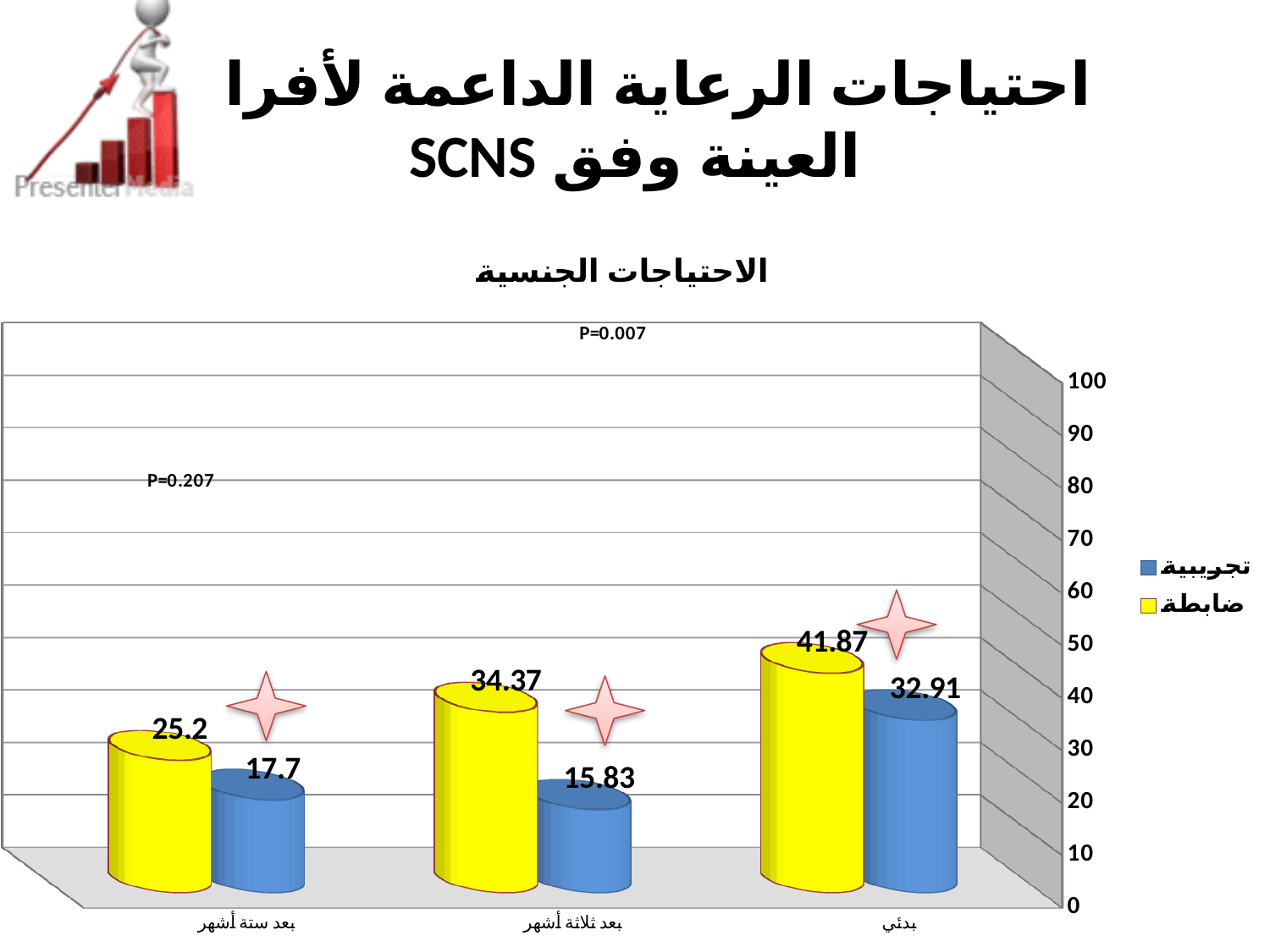
At بعد ستة أشهر, which series has the larger value, ضابطة or تجريبية? ضابطة What is the value for the تجريبية series at بعد ثلاثة أشهر? 15.83 What is the value for the ضابطة series at بعد ستة أشهر? 25.2 What is the value for the تجريبية series at بدئي? 32.91 What kind of chart is shown on the slide? bar chart Which category has the highest value for the تجريبية series? بدئي What is the difference between the ضابطة and تجريبية values at بعد ثلاثة أشهر? 18.54 What is the value for the ضابطة series at بدئي? 41.87 How many categories are shown on the x axis? 3 What is the title of the chart? الاحتياجات الجنسية Which category has the lowest value for the ضابطة series? بعد ستة أشهر How many series does the legend list? 2